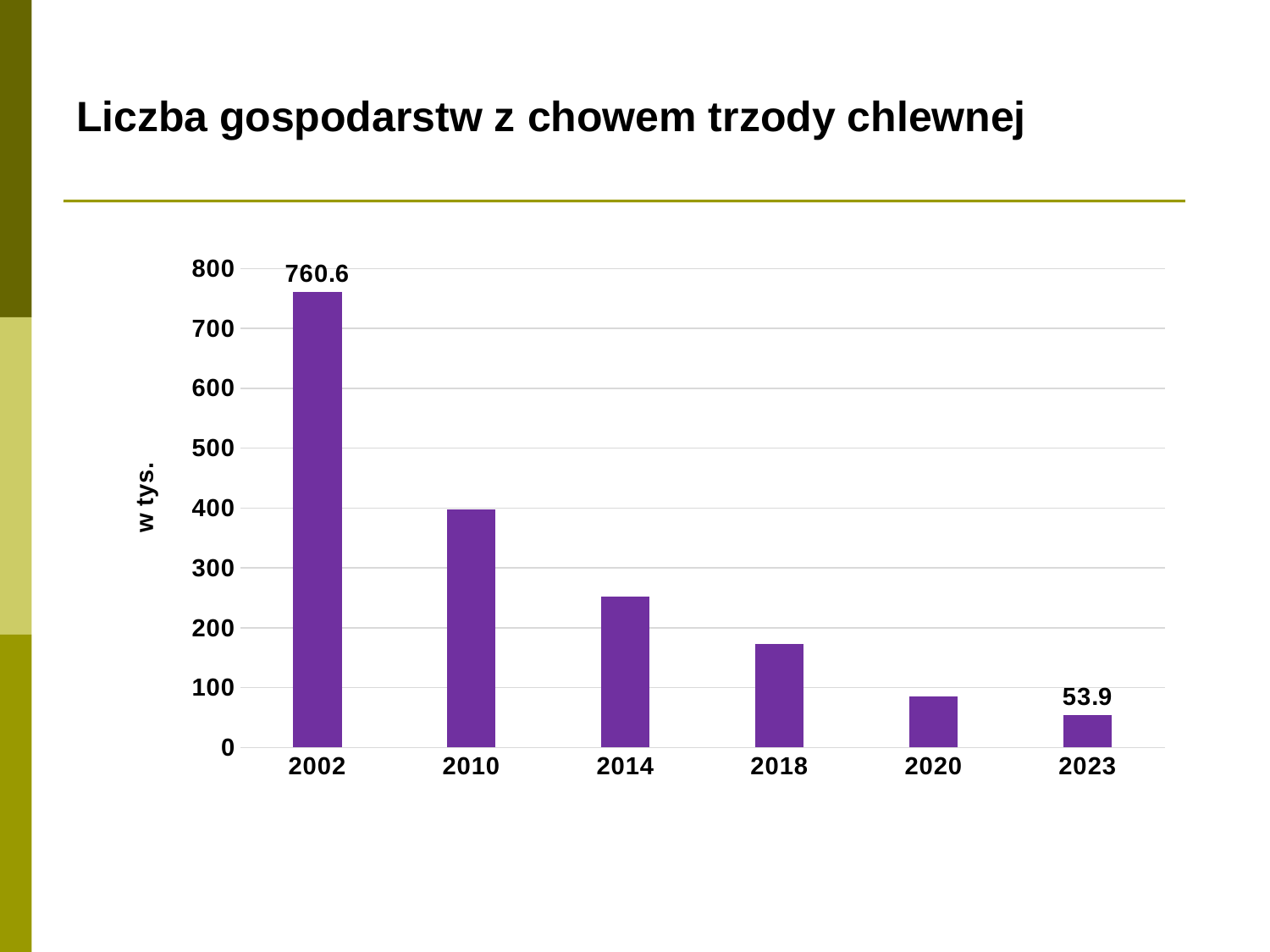
Which year has the lowest value? 2023 What is the value for 2002? 760.6 Is the value for 2018 greater or less than 200? less Which is larger, the value for 2010 or the value for 2014? 2010 Which year has the highest value? 2002 Do the values rise or fall from 2002 to 2023? fall Is the value for 2020 greater or less than 100? less What is the value for 2023? 53.9 What is the difference between the values for 2002 and 2023? 706.7 How many years are shown on the x axis? 6 What kind of chart is shown? bar chart Is the value for 2010 greater or less than 300? greater